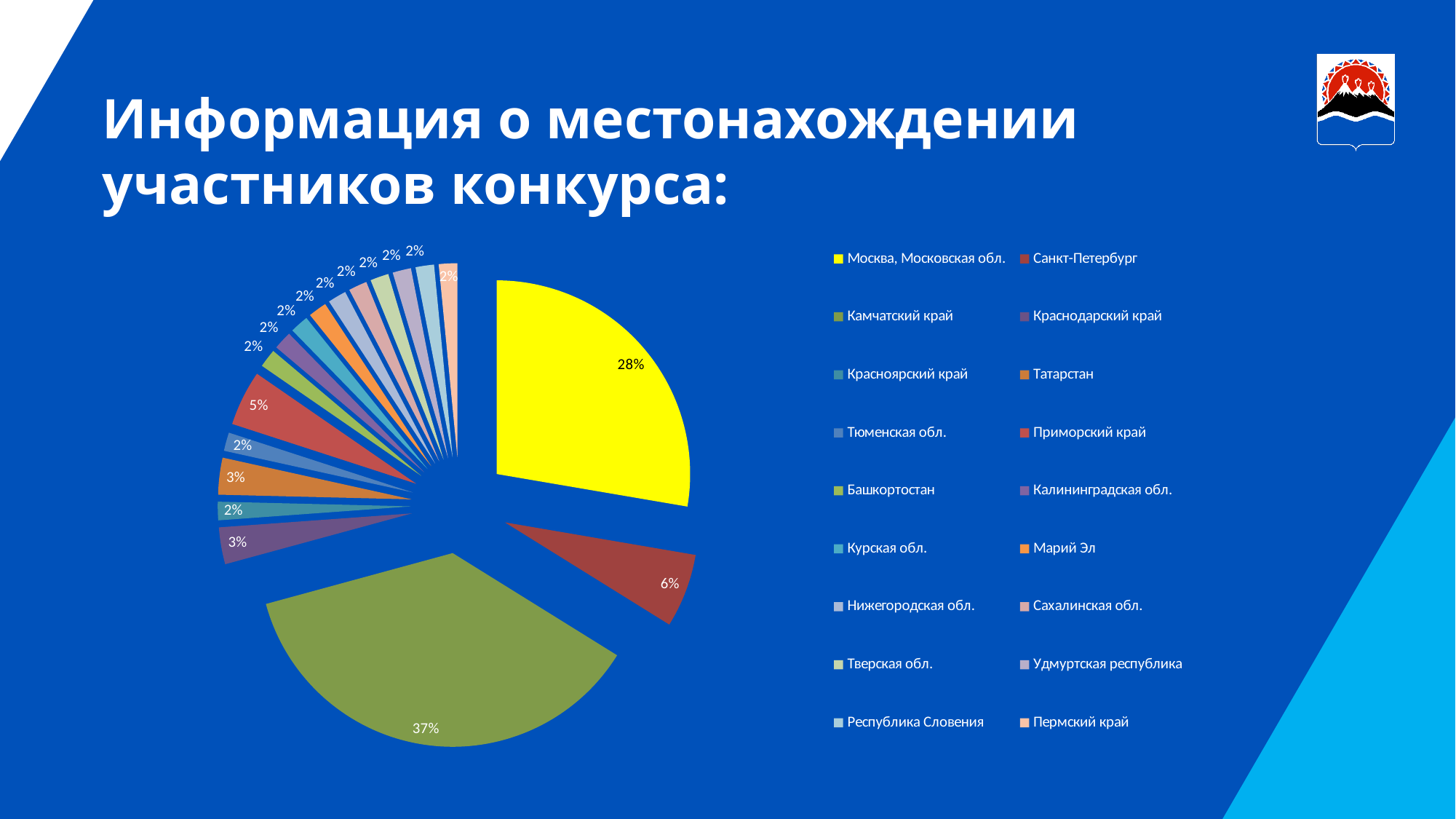
What share of the pie does Санкт-Петербург have? 6% Which region has the largest slice of the pie? Камчатский край What kind of chart is shown on the slide? pie chart What is the title of the slide? Информация о местонахождении участников конкурса: What is the combined share of Камчатский край and Москва, Московская обл.? 65% Which has the larger share: Москва, Московская обл. or Санкт-Петербург? Москва, Московская обл. What share of the pie does Москва, Московская обл. have? 28% What is the difference in percentage points between the shares of Камчатский край and Москва, Московская обл.? 9 What share of the pie does Татарстан have? 3% How many regions are listed in the chart legend? 18 What share of the pie does Приморский край have? 5% What share of the pie does Камчатский край have? 37%